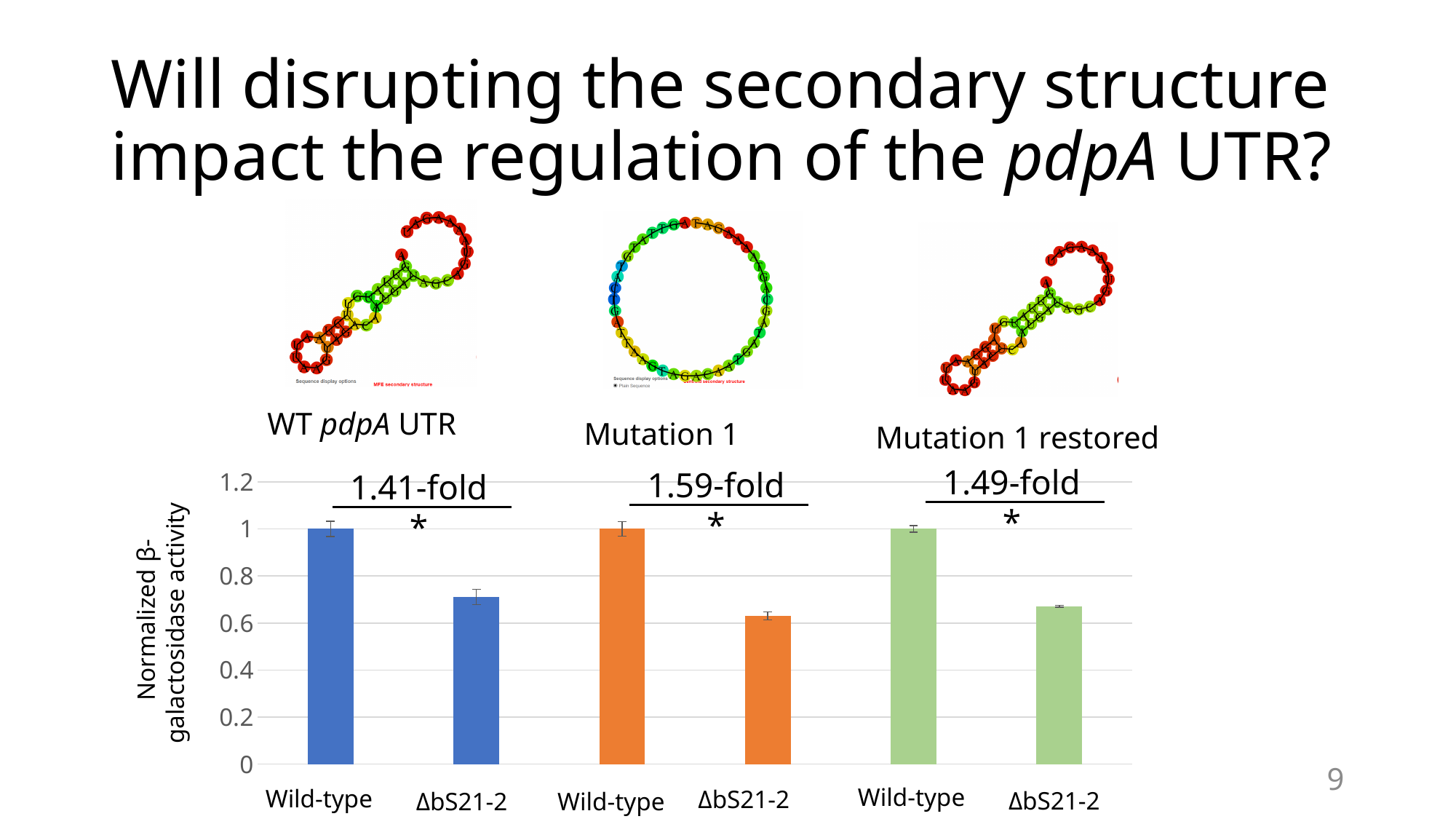
What fold change is annotated above the Mutation 1 pair of bars? 1.59-fold Is the value for ΔbS21-2 in the WT pdpA UTR group greater or less than 0.8? less What fold change is annotated above the Mutation 1 restored pair of bars? 1.49-fold How many bars are plotted in the chart? 6 Is the value for ΔbS21-2 in the WT pdpA UTR group greater or less than 0.6? greater In the Mutation 1 group, which bar is larger, Wild-type or ΔbS21-2? Wild-type What kind of chart is shown on the slide? bar chart What colour are the bars for the Mutation 1 group? orange What fold change is annotated above the WT pdpA UTR pair of bars? 1.41-fold Is the value for ΔbS21-2 in the Mutation 1 group greater or less than 0.8? less What is the normalized β-galactosidase activity for Wild-type in the WT pdpA UTR group? 1 What is the label on the y axis of the chart? Normalized β-galactosidase activity